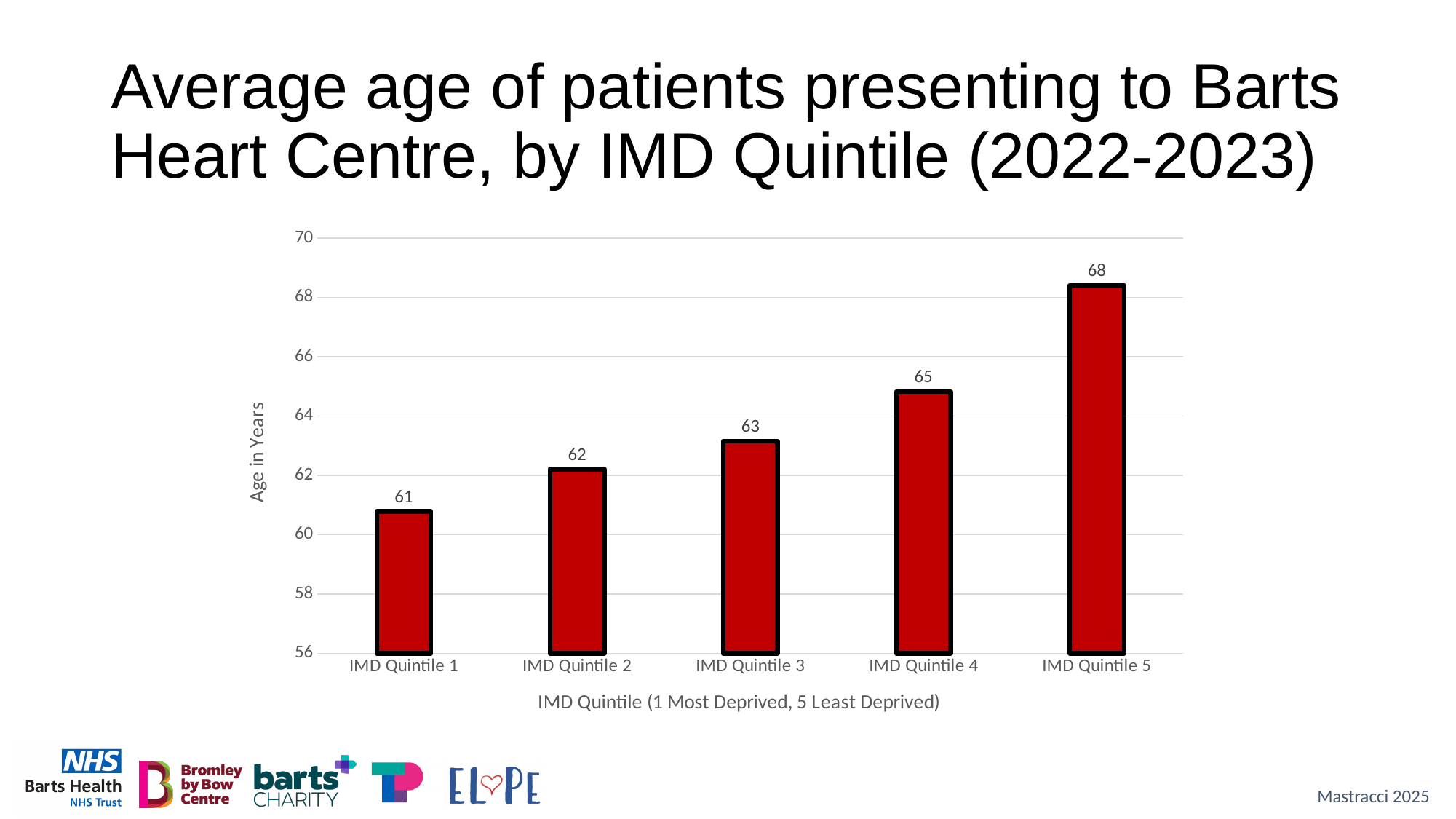
Which has a higher average age, IMD Quintile 2 or IMD Quintile 4? IMD Quintile 4 Is the value for IMD Quintile 4 greater or less than 64? greater What is the average age for IMD Quintile 5? 68 What is the difference in average age between IMD Quintile 4 and IMD Quintile 2? 3 What is the average age for IMD Quintile 3? 63 What kind of chart is shown on the slide? Bar chart What is the average age for IMD Quintile 1? 61 What is the difference in average age between IMD Quintile 5 and IMD Quintile 1? 7 Which IMD quintile has the lowest average age? IMD Quintile 1 Does the average age rise or fall from IMD Quintile 1 to IMD Quintile 5? Rise Which IMD quintile has the highest average age? IMD Quintile 5 How many IMD quintiles are shown on the chart? 5